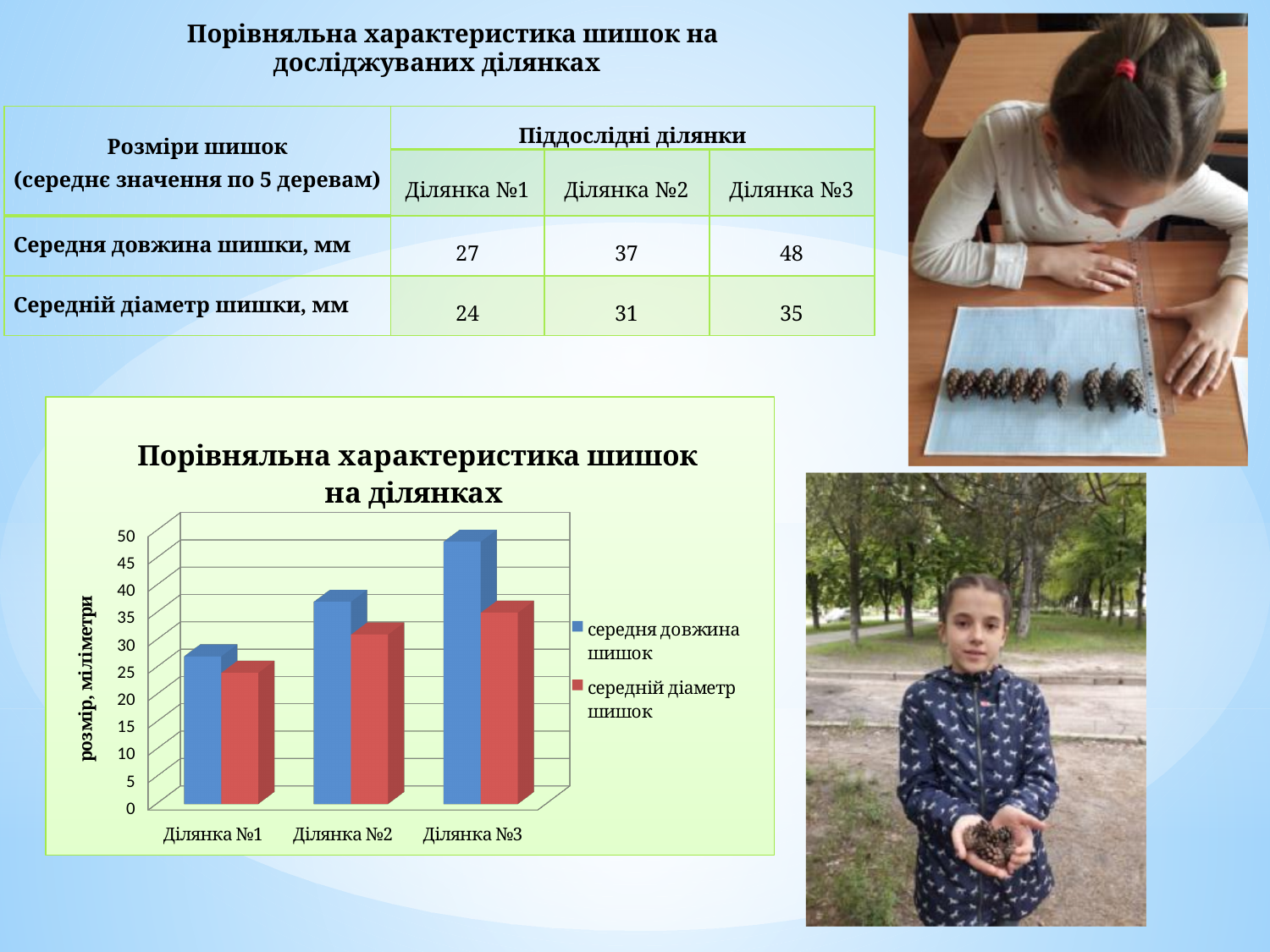
Is the value for середня довжина шишок at Ділянка №3 greater or less than 45? greater Which ділянка has the lowest value for середній діаметр шишок? Ділянка №1 What kind of chart is shown on the slide? bar chart Do the values for середня довжина шишок rise or fall from Ділянка №1 to Ділянка №3? rise How many categories (ділянки) are shown on the x axis of the chart? 3 What is the value for середня довжина шишок at Ділянка №2, as given in the table on the slide? 37 How many series does the chart legend list? 2 Is the value for середній діаметр шишок at Ділянка №1 greater or less than 25? less Which ділянка has the highest value for середня довжина шишок? Ділянка №3 Which is larger at Ділянка №2: середня довжина шишок or середній діаметр шишок? середня довжина шишок What is the title of the chart? Порівняльна характеристика шишок на ділянках What is the label of the vertical axis of the chart? розмір, міліметри